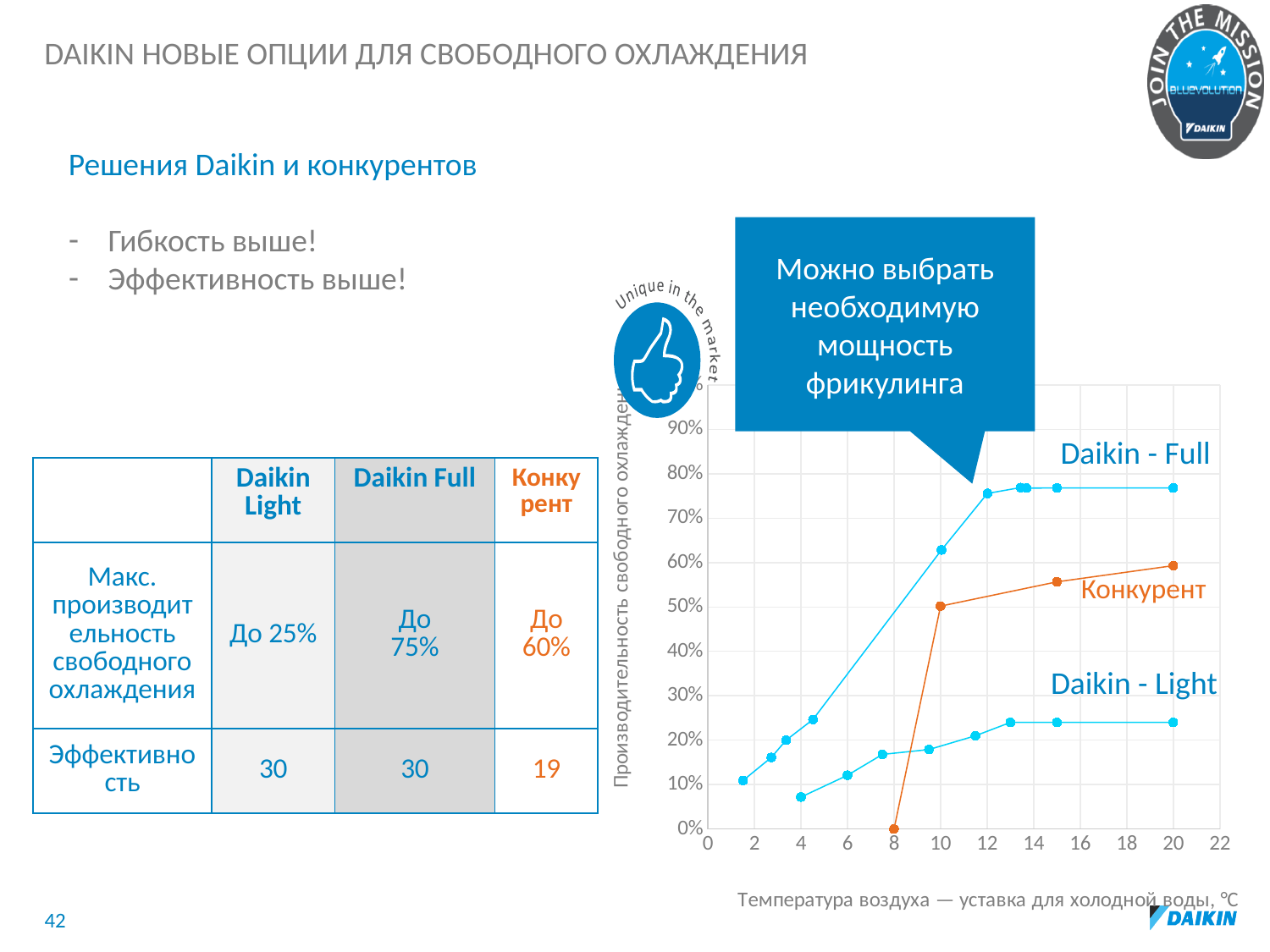
Which series has the lowest values at the right end of the chart (x = 20)? Daikin - Light Is the value for Конкурент at x = 20 greater or less than 50%? greater Is the value for Daikin - Full at x = 20 greater or less than 70%? greater Which series reaches the highest value on the chart? Daikin - Full Is the value for Daikin - Light at x = 20 greater or less than 30%? less What is the value for Конкурент at x = 8? 0% What kind of chart is shown on the slide? line chart At x = 10, which is larger: Daikin - Light or Конкурент? Конкурент What is the x-axis title of the chart? Температура воздуха — уставка для холодной воды, °C How many series are plotted on the chart? 3 Do the values for Daikin - Full rise or fall as the x axis increases? rise